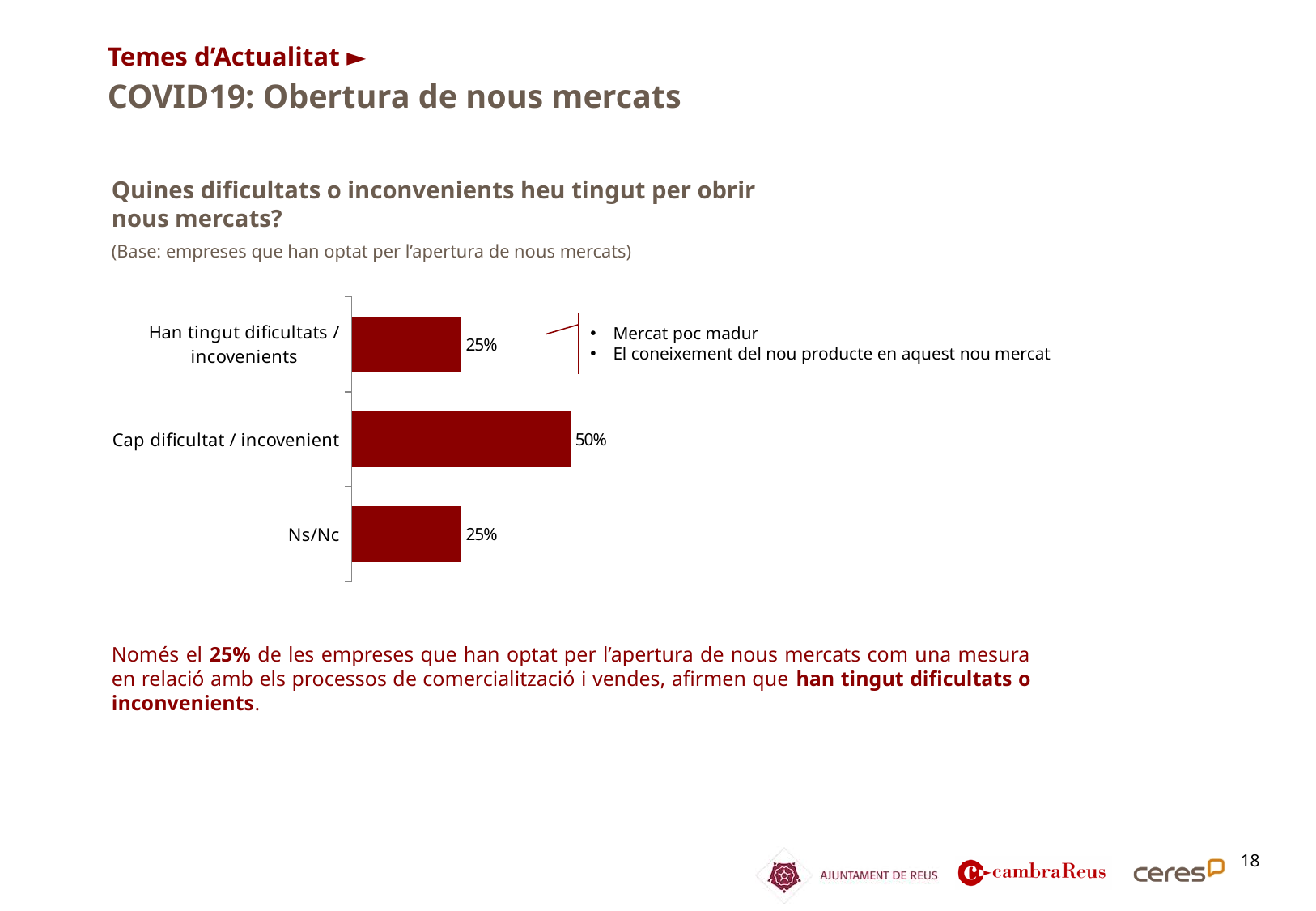
What is the value for "Cap dificultat / incovenient"? 50% What question does the chart answer, according to the heading above it? Quines dificultats o inconvenients heu tingut per obrir nous mercats? Which is larger, the value for "Cap dificultat / incovenient" or the value for "Ns/Nc"? Cap dificultat / incovenient What kind of chart is shown on the slide? Bar chart What is the value for "Han tingut dificultats / inconvenients"? 25% What is the difference between the values for "Cap dificultat / incovenient" and "Han tingut dificultats / inconvenients"? 25% What is the total of the three values shown in the chart? 100% Which category has the highest value? Cap dificultat / incovenient How many categories are shown in the chart? 3 What colour are the bars in the chart? Dark red What is the value for "Ns/Nc"? 25%